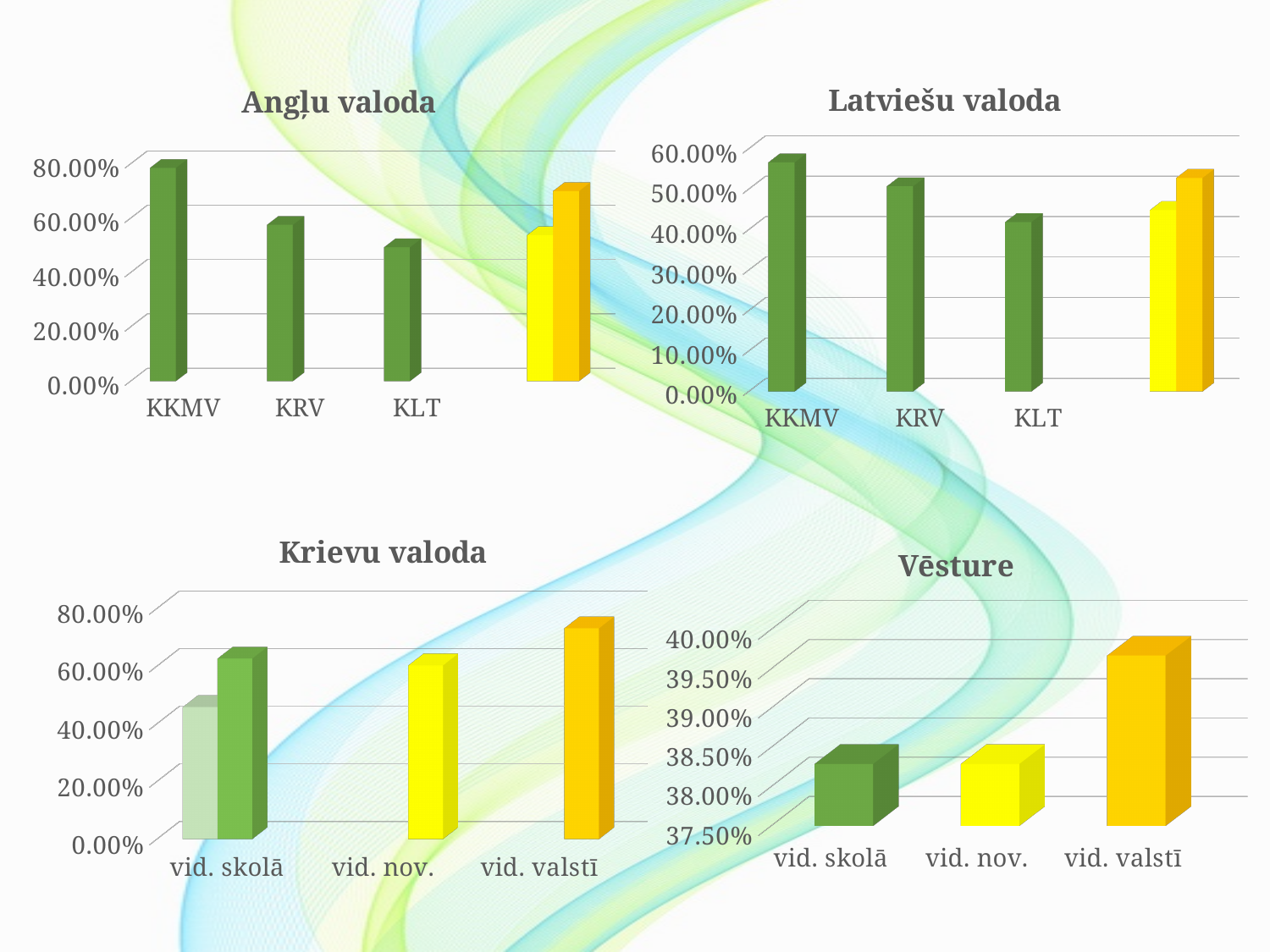
In the Vēsture chart, which category has the highest value? vid. valstī What type of chart is the Vēsture chart? bar chart In the Angļu valoda chart, which labeled category has the highest value? KKMV In the Latviešu valoda chart, is the value for KLT greater or less than 50.00%? less In the Latviešu valoda chart, which is larger, the value for KRV or the value for KLT? KRV In the Krievu valoda chart, is the value for vid. valstī greater or less than 60.00%? greater In the Latviešu valoda chart, which labeled category has the highest value? KKMV In the Angļu valoda chart, is the value for KLT greater or less than 60.00%? less In the Angļu valoda chart, which labeled category has the lowest value? KLT